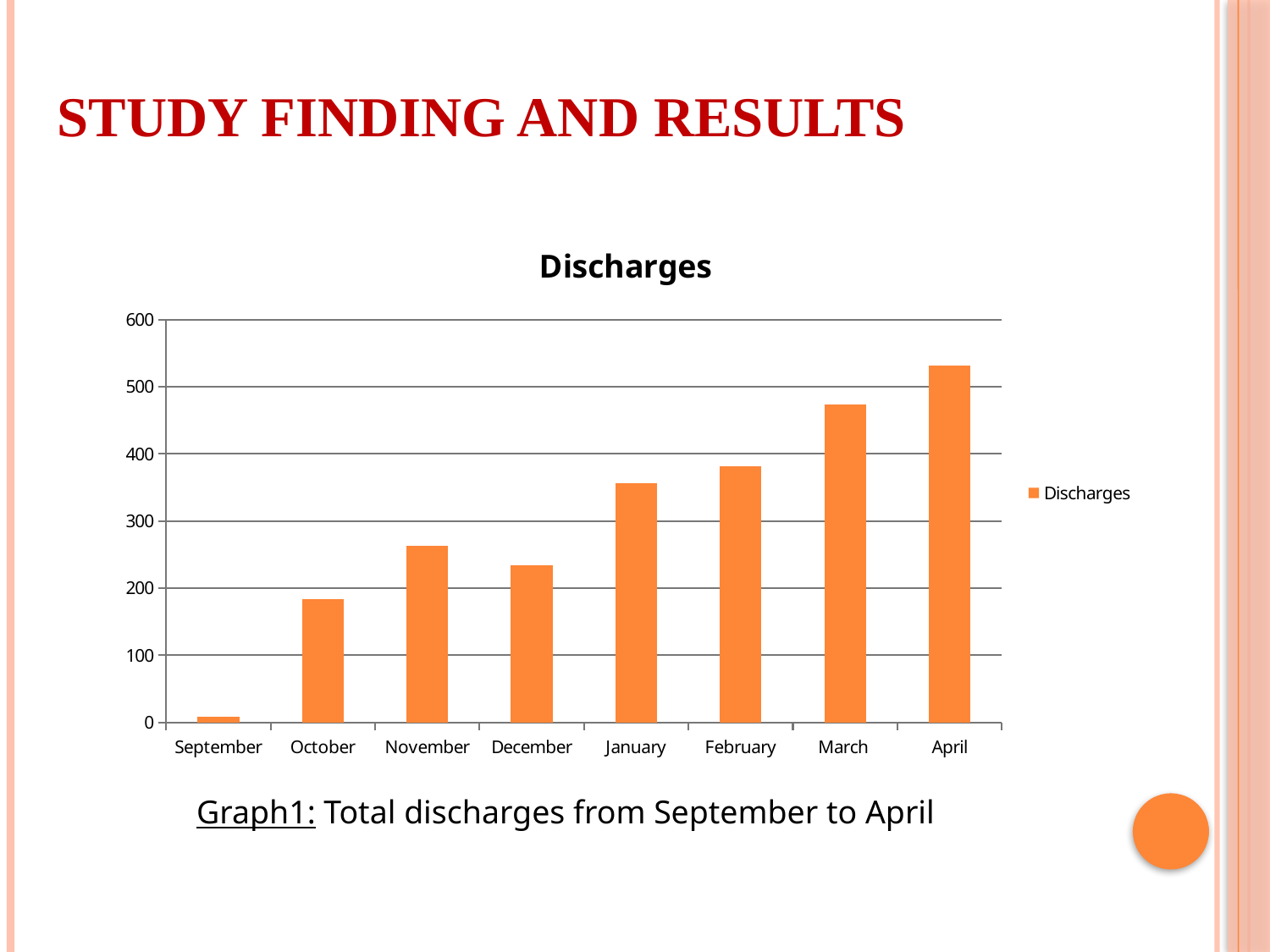
Is the value for January greater or less than 300? greater Which month has the highest number of discharges? April Is the value for April greater or less than 500? greater Which month has more discharges, November or December? November Which month has the lowest number of discharges? September Is the value for September greater or less than 100? less How many series does the legend list? 1 Do the discharges generally rise or fall from September to April? rise What is the title of the chart? Discharges What kind of chart is shown on the slide? bar chart How many months are shown on the x axis of the chart? 8